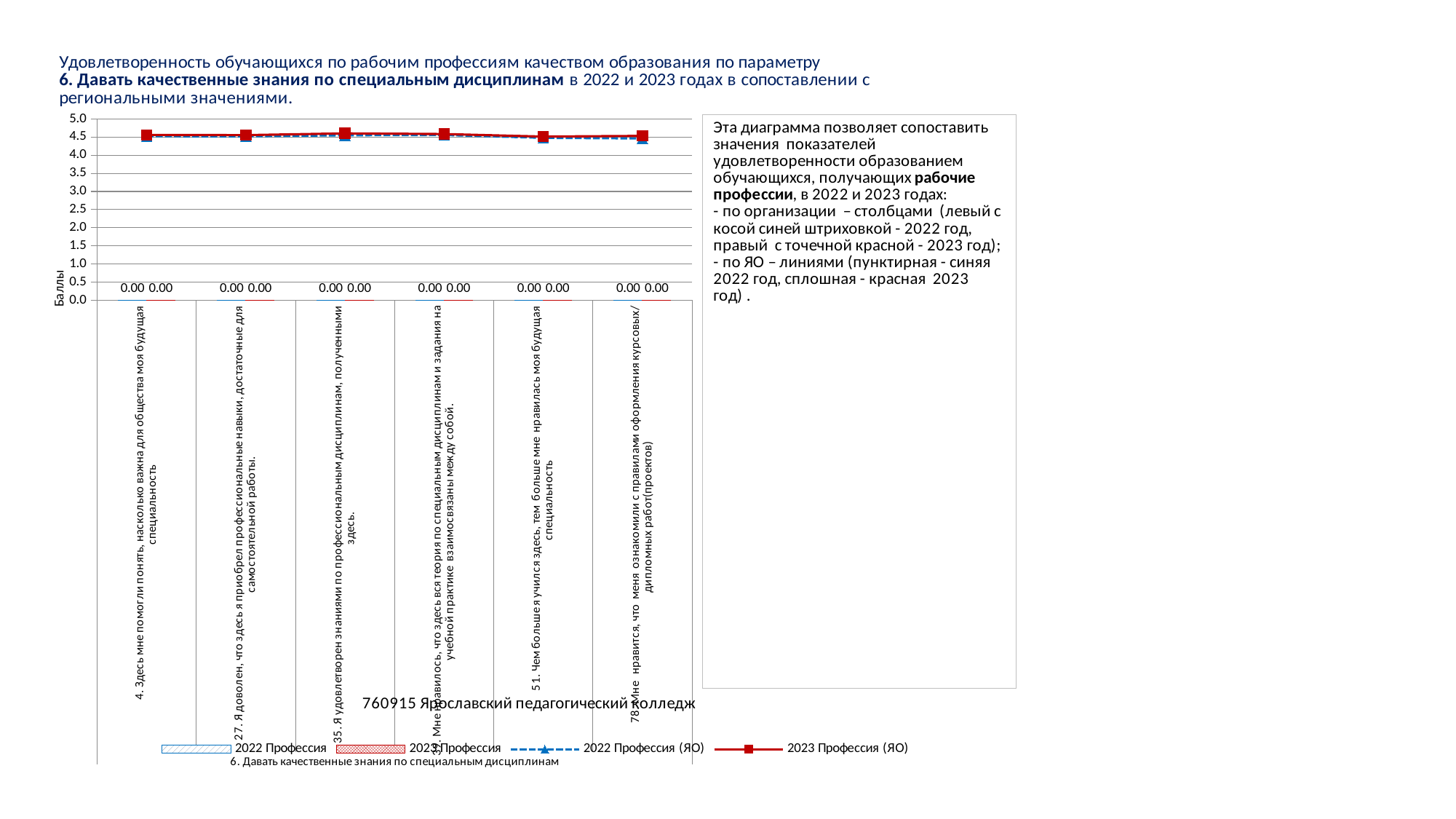
What is the value of the 2022 Профессия series for category 4 ("Здесь мне помогли понять, насколько важна для общества моя будущая специальность")? 0.00 What is the value of the 2023 Профессия series for category 51 ("Чем больше я учился здесь, тем больше мне нравилась моя будущая специальность")? 0.00 Is the value of the 2022 Профессия (ЯО) series for category 35 greater or less than 3.0? greater How many series does the chart legend list? 4 What kind of chart is shown on the slide? Combined bar and line chart What is the difference between the 2022 Профессия and 2023 Профессия values for category 27? 0.00 How many categories are shown on the x axis of the chart? 6 What is the value of the 2023 Профессия series for category 78 ("Мне нравится, что меня ознакомили с правилами оформления курсовых/дипломных работ(проектов)")? 0.00 Is the value of the 2023 Профессия (ЯО) series for category 4 greater or less than 4.0? greater For category 51, which is larger: the 2023 Профессия (ЯО) value or the 2023 Профессия value? 2023 Профессия (ЯО) What is the title of the vertical axis of the chart? Баллы Which series is drawn as a solid red line with square markers? 2023 Профессия (ЯО)